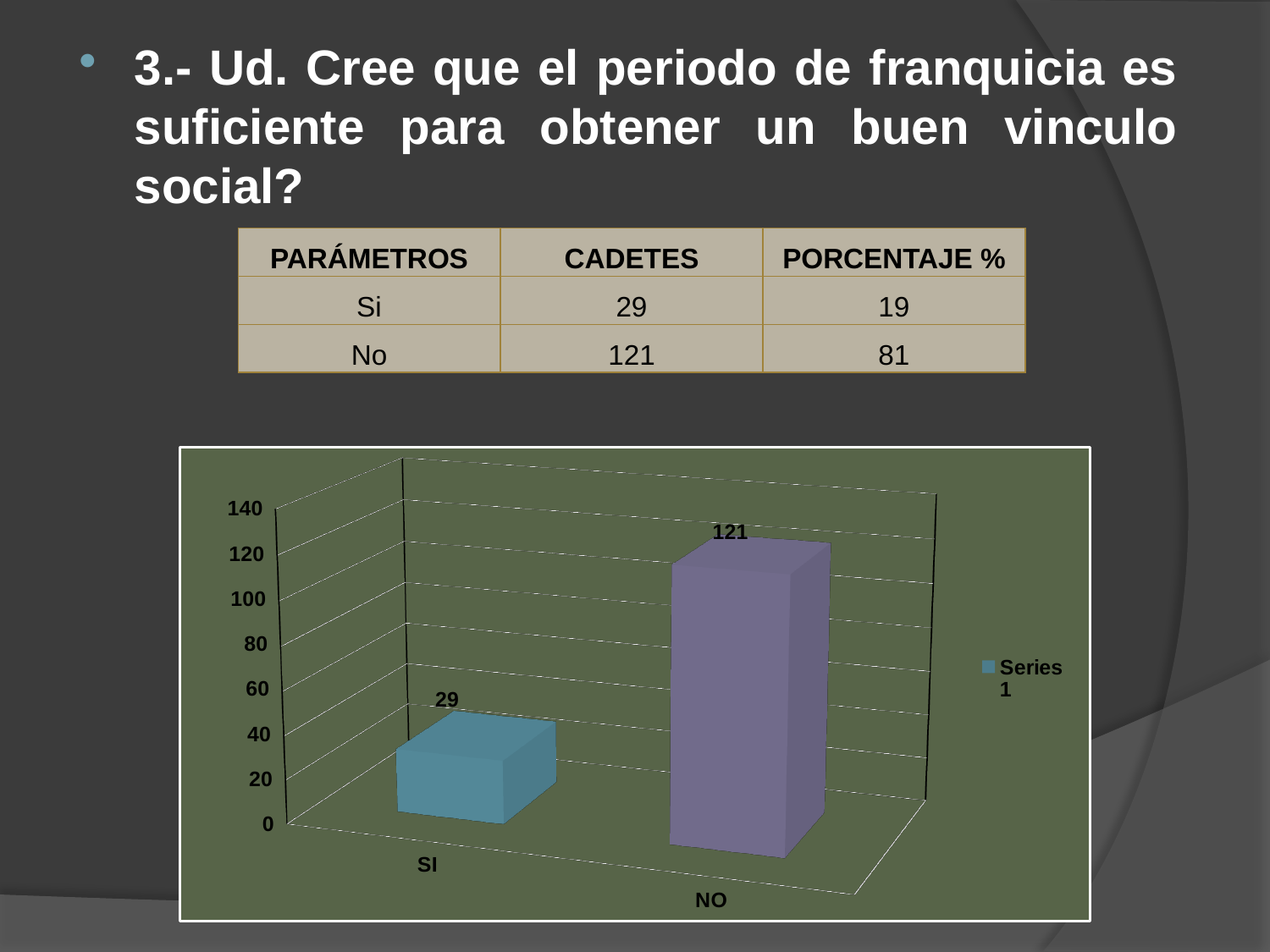
What is the value for NO in the chart? 121 How many categories are shown in the chart? 2 Which category has the lowest value in the chart? SI What is the name of the series listed in the chart legend? Series 1 Which is larger in the chart, the value for SI or the value for NO? NO What is the value for SI in the chart? 29 Is the value for NO greater or less than 100? greater Is the value for SI greater or less than 40? less Which category has the highest value in the chart? NO What is the difference between the values for NO and SI in the chart? 92 How many series does the chart legend list? 1 What kind of chart is shown on the slide? bar chart